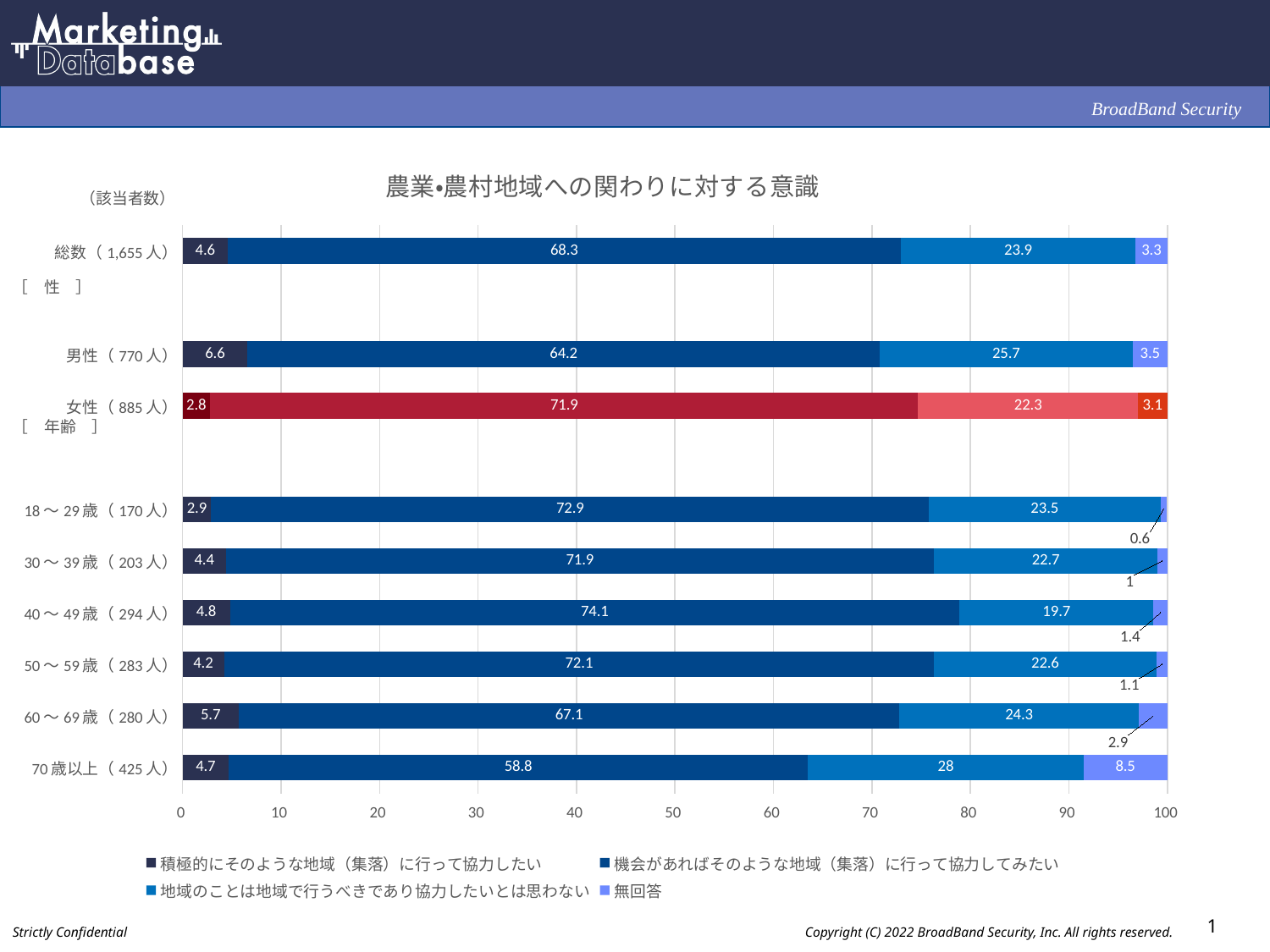
What is the value of 機会があればそのような地域（集落）に行って協力してみたい for 女性（885人）? 71.9 What is the value of 無回答 for 70歳以上（425人）? 8.5 Which category has the highest value for 機会があればそのような地域（集落）に行って協力してみたい? 40～49歳（294人） Which is larger: the 積極的にそのような地域（集落）に行って協力したい value for 男性（770人）or for 女性（885人）? 男性（770人） What is the total of the stacked bar for 総数（1,655人）? 100.1 What is the difference between the 地域のことは地域で行うべきであり協力したいとは思わない values for 70歳以上（425人）and 40～49歳（294人）? 8.3 How many categories are shown on the y axis of the chart? 9 What kind of chart is shown on the slide? Stacked bar chart Which category has the lowest value for 無回答? 18～29歳（170人） How many series does the legend list? 4 What is the value of 積極的にそのような地域（集落）に行って協力したい for 男性（770人）? 6.6 What is the title of the chart? 農業•農村地域への関わりに対する意識